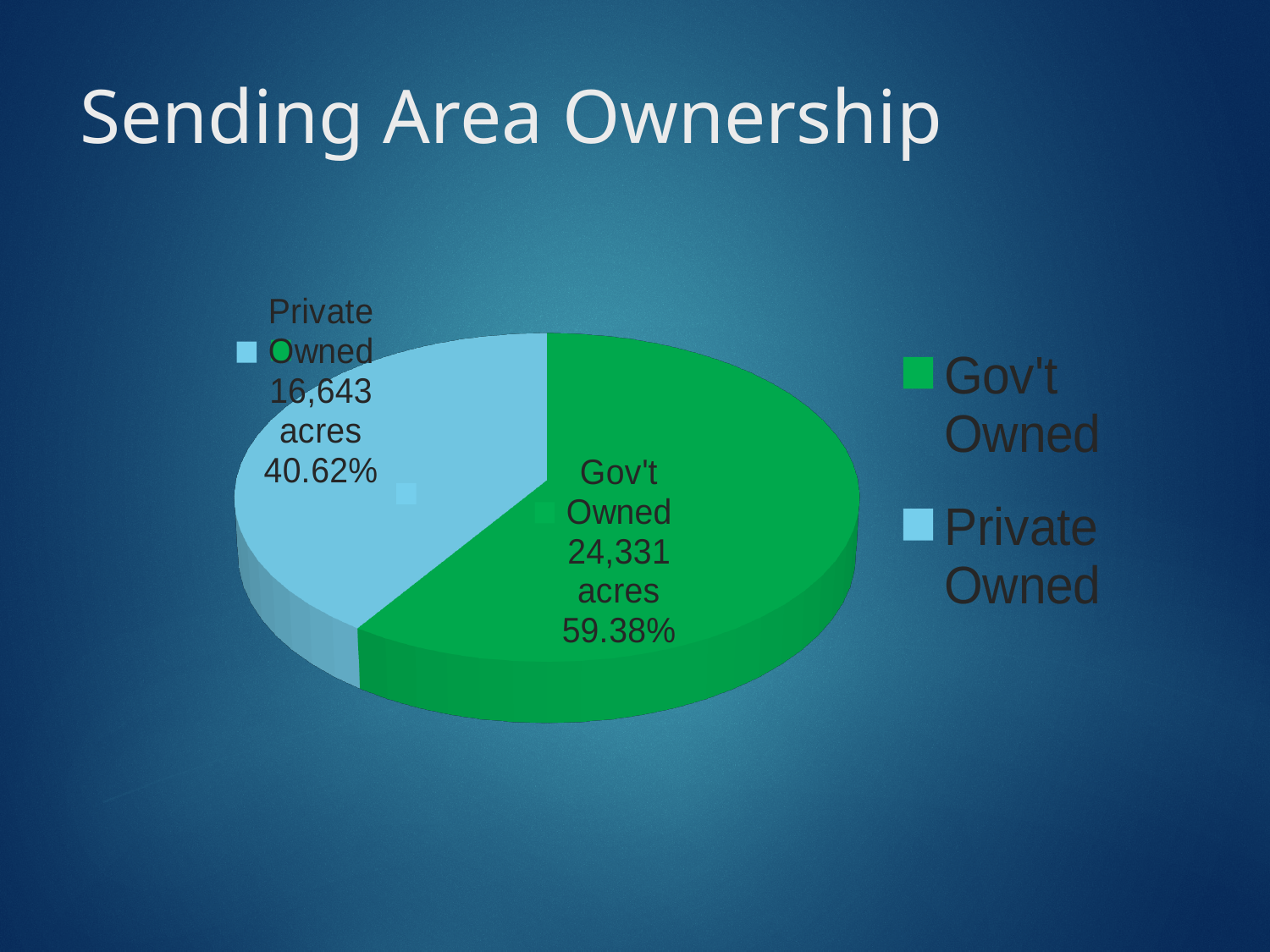
How many acres are Gov't Owned? 24,331 acres Which category has the largest slice? Gov't Owned How many more acres are Gov't Owned than Private Owned? 7,688 acres What share of the pie is Gov't Owned? 59.38% What share of the pie is Private Owned? 40.62% How many categories does the pie chart have? 2 How many acres are Private Owned? 16,643 acres What is the title of the slide? Sending Area Ownership Which is larger, the Gov't Owned slice or the Private Owned slice? Gov't Owned What kind of chart is shown on the slide? pie chart What is the total number of acres across both categories? 40,974 acres Which category has the smallest slice? Private Owned